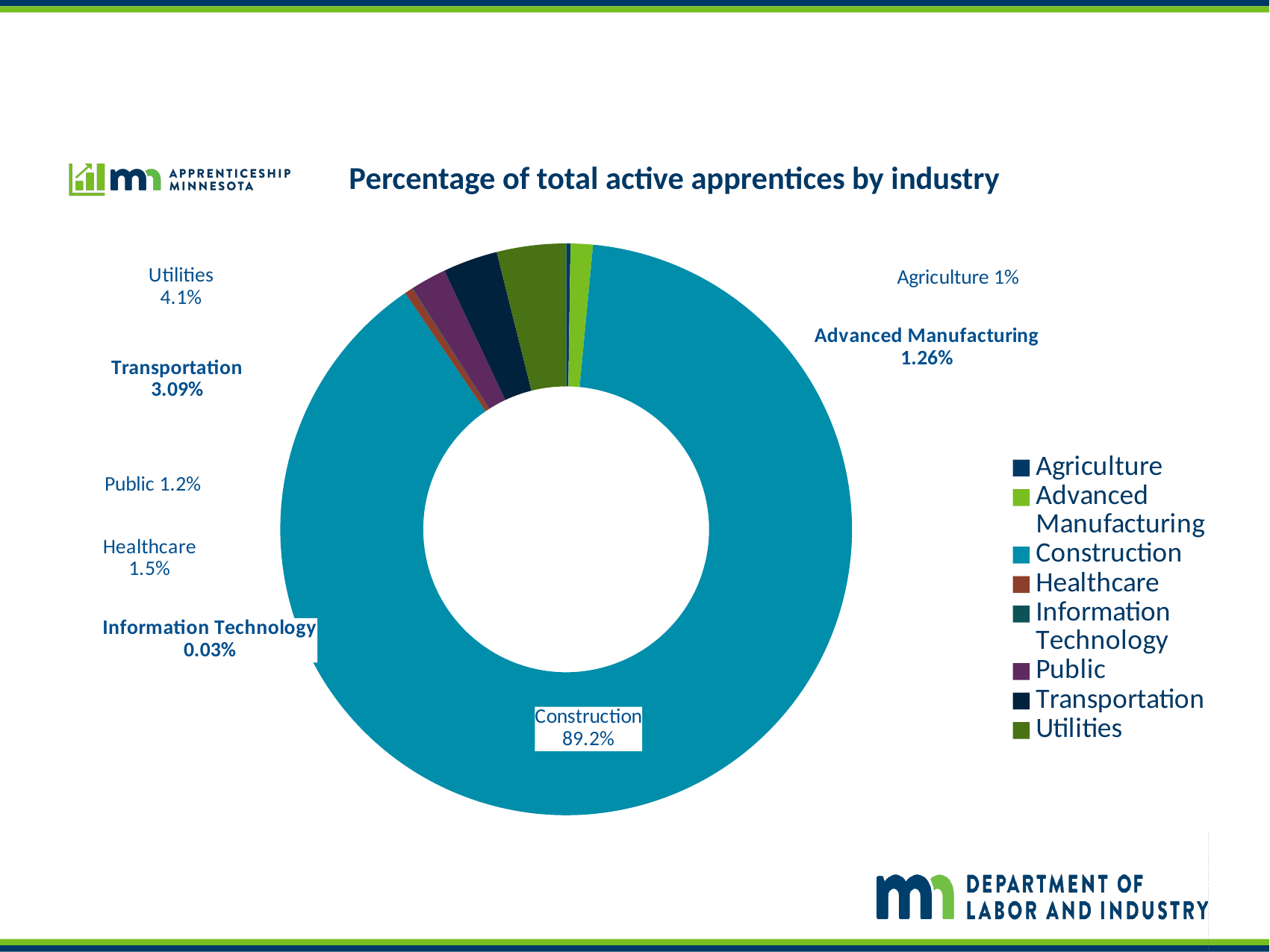
How many industries are shown in the chart? 8 Which industry has the largest share of total active apprentices? Construction What kind of chart is shown on the slide? Pie chart (doughnut) What percentage of total active apprentices are in Utilities? 4.1% What is the title of the chart? Percentage of total active apprentices by industry What percentage of total active apprentices are in Information Technology? 0.03% Which industry has the smallest share of total active apprentices? Information Technology What is the difference in percentage points between the Utilities share and the Transportation share? 1.01 Which has a larger share of active apprentices, Utilities or Transportation? Utilities What percentage of total active apprentices are in Transportation? 3.09% What percentage of total active apprentices are in Advanced Manufacturing? 1.26% What percentage of total active apprentices are in Construction? 89.2%